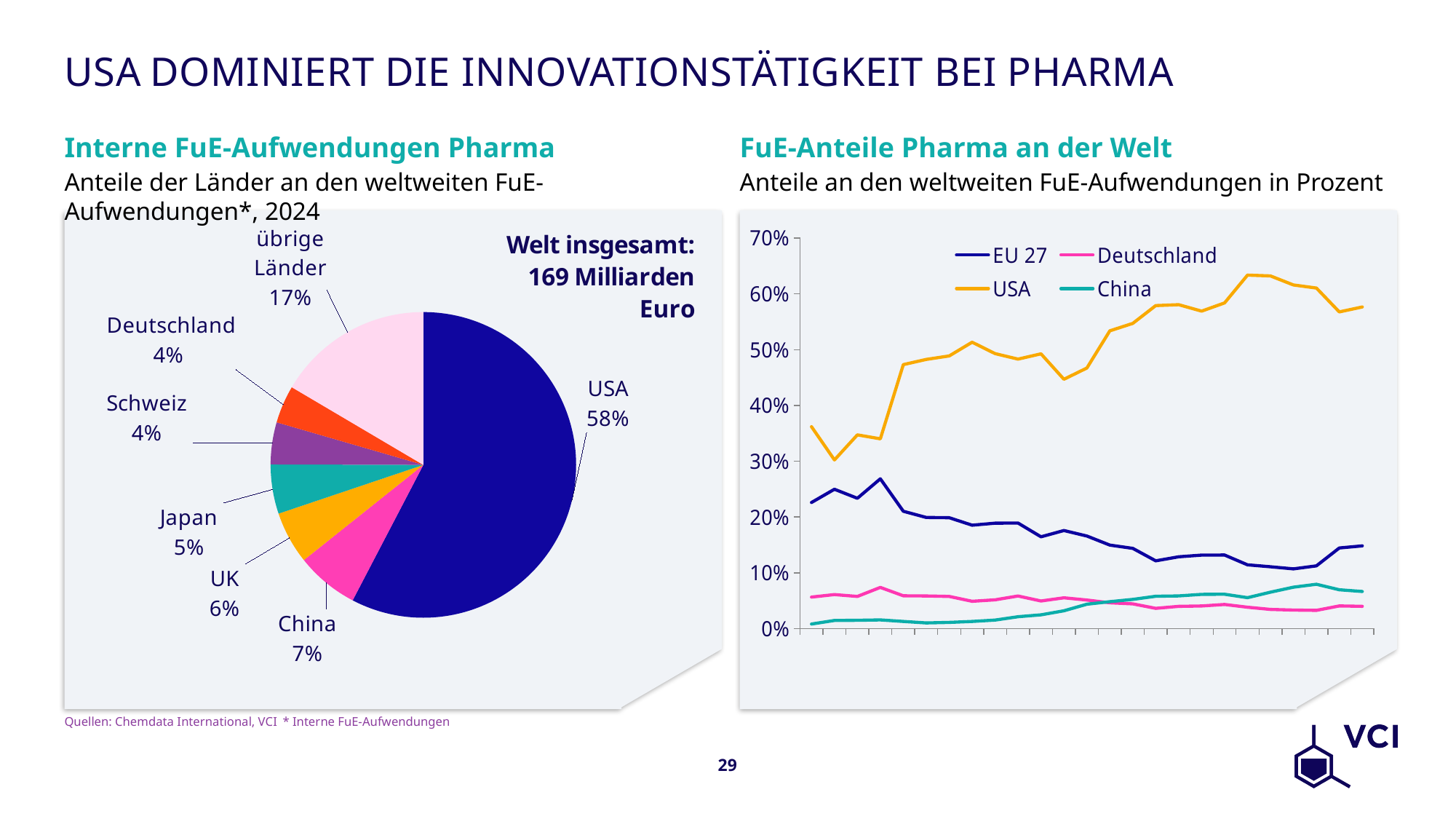
In the line chart 'FuE-Anteile Pharma an der Welt', is the final value for the USA greater or less than 50%? greater In the pie chart 'Interne FuE-Aufwendungen Pharma', what share does China have? 7% In the line chart 'FuE-Anteile Pharma an der Welt', how many series does the legend list? 4 In the pie chart 'Interne FuE-Aufwendungen Pharma', how many slices are shown? 7 In the line chart 'FuE-Anteile Pharma an der Welt', does the USA line generally rise or fall along the x axis? Rise In the pie chart 'Interne FuE-Aufwendungen Pharma', which country has the largest share? USA In the pie chart 'Interne FuE-Aufwendungen Pharma', what is the difference between the shares of the USA and übrige Länder? 41 percentage points In the pie chart 'Interne FuE-Aufwendungen Pharma', what share does the USA have? 58% What kind of chart is 'Interne FuE-Aufwendungen Pharma'? Pie chart In the pie chart 'Interne FuE-Aufwendungen Pharma', what is the total world value stated on the chart? 169 Milliarden Euro In the line chart 'FuE-Anteile Pharma an der Welt', does the EU 27 line generally rise or fall along the x axis? Fall In the pie chart 'Interne FuE-Aufwendungen Pharma', which has the larger share, UK or Japan? UK